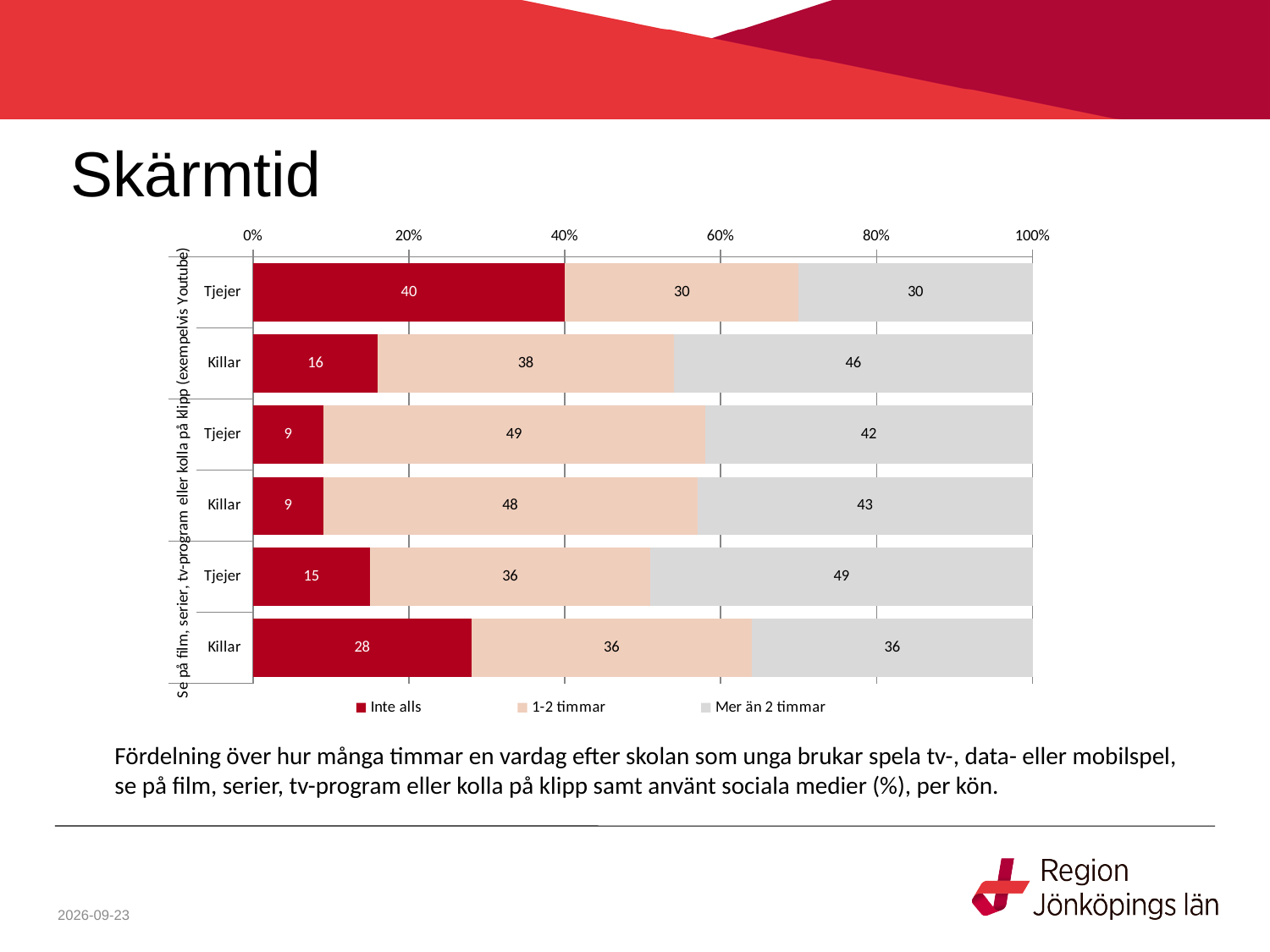
How many bars are plotted in the chart? 6 Which bar has the highest 'Inte alls' value? The top bar (Tjejer) What is the 'Inte alls' value for the bottom bar (Killar)? 28 What type of chart is shown on the slide? Stacked bar chart What is the 'Mer än 2 timmar' value for the second bar from the top (Killar)? 46 What are the three legend entries of the chart? Inte alls, 1-2 timmar, Mer än 2 timmar Which is larger: the 'Mer än 2 timmar' value for the fifth bar (Tjejer) or for the bottom bar (Killar)? The fifth bar (Tjejer) Which bar has the highest 'Mer än 2 timmar' value? The fifth bar from the top (Tjejer) What is the 'Inte alls' value for the top bar (Tjejer)? 40 What is the difference between the 'Inte alls' values of the top bar (Tjejer) and the second bar (Killar)? 24 What is the '1-2 timmar' value for the third bar from the top (Tjejer)? 49 How many series does the legend list? 3